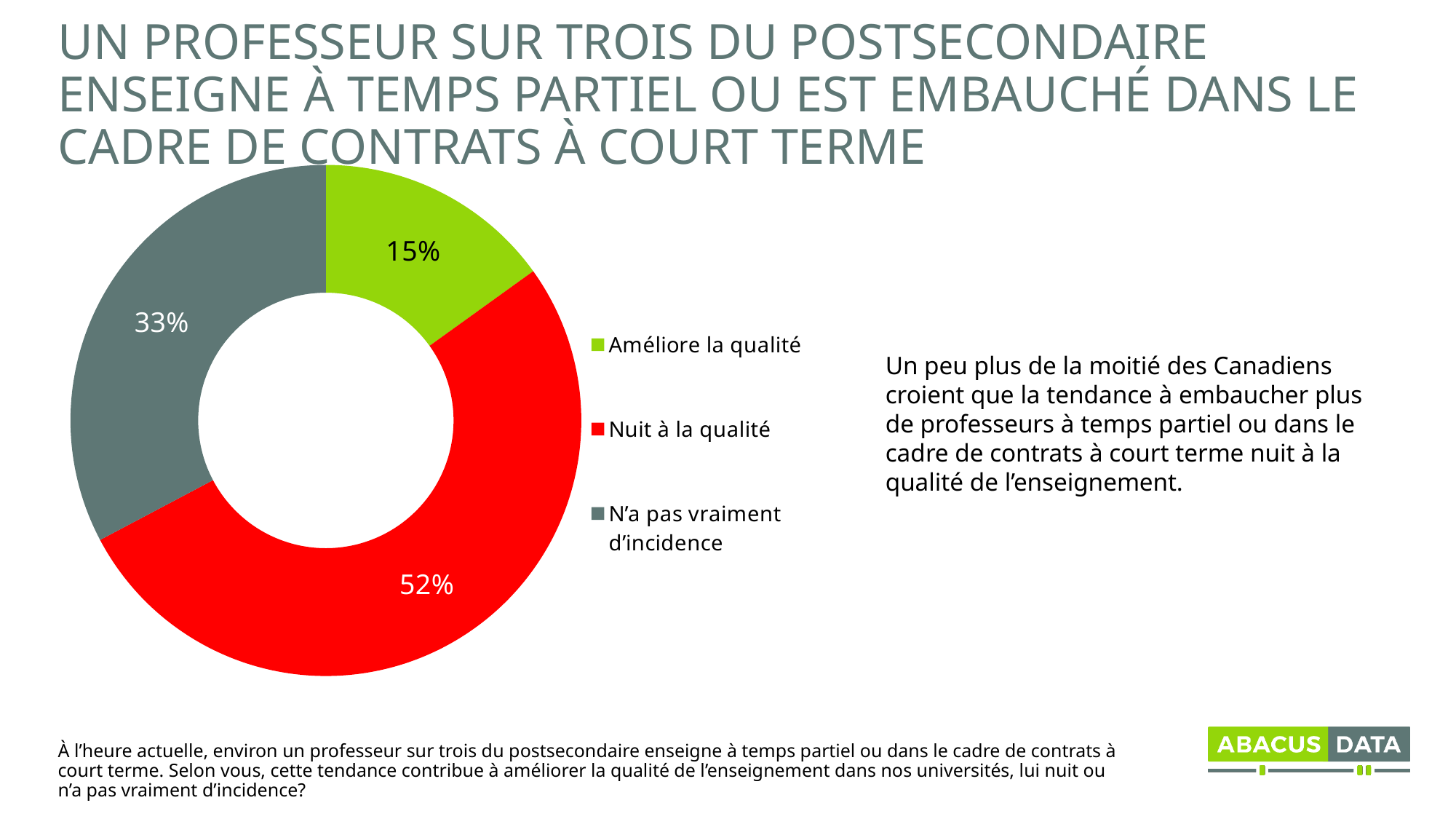
How many categories are shown in the chart? 3 What percentage of respondents said the trend "Nuit à la qualité"? 52% What kind of chart is shown on the slide? Doughnut (pie) chart Which is larger: the share for "Améliore la qualité" or the share for "N'a pas vraiment d'incidence"? N'a pas vraiment d'incidence Which response category has the smallest share of the chart? Améliore la qualité What colour represents "Nuit à la qualité" in the chart? Red What percentage of respondents said the trend "Améliore la qualité"? 15% Which response category has the largest share of the chart? Nuit à la qualité What is the difference in percentage points between "N'a pas vraiment d'incidence" and "Améliore la qualité"? 18 What colour represents "Améliore la qualité" in the chart? Green What is the difference in percentage points between "Nuit à la qualité" and "N'a pas vraiment d'incidence"? 19 What percentage of respondents said the trend "N'a pas vraiment d'incidence"? 33%